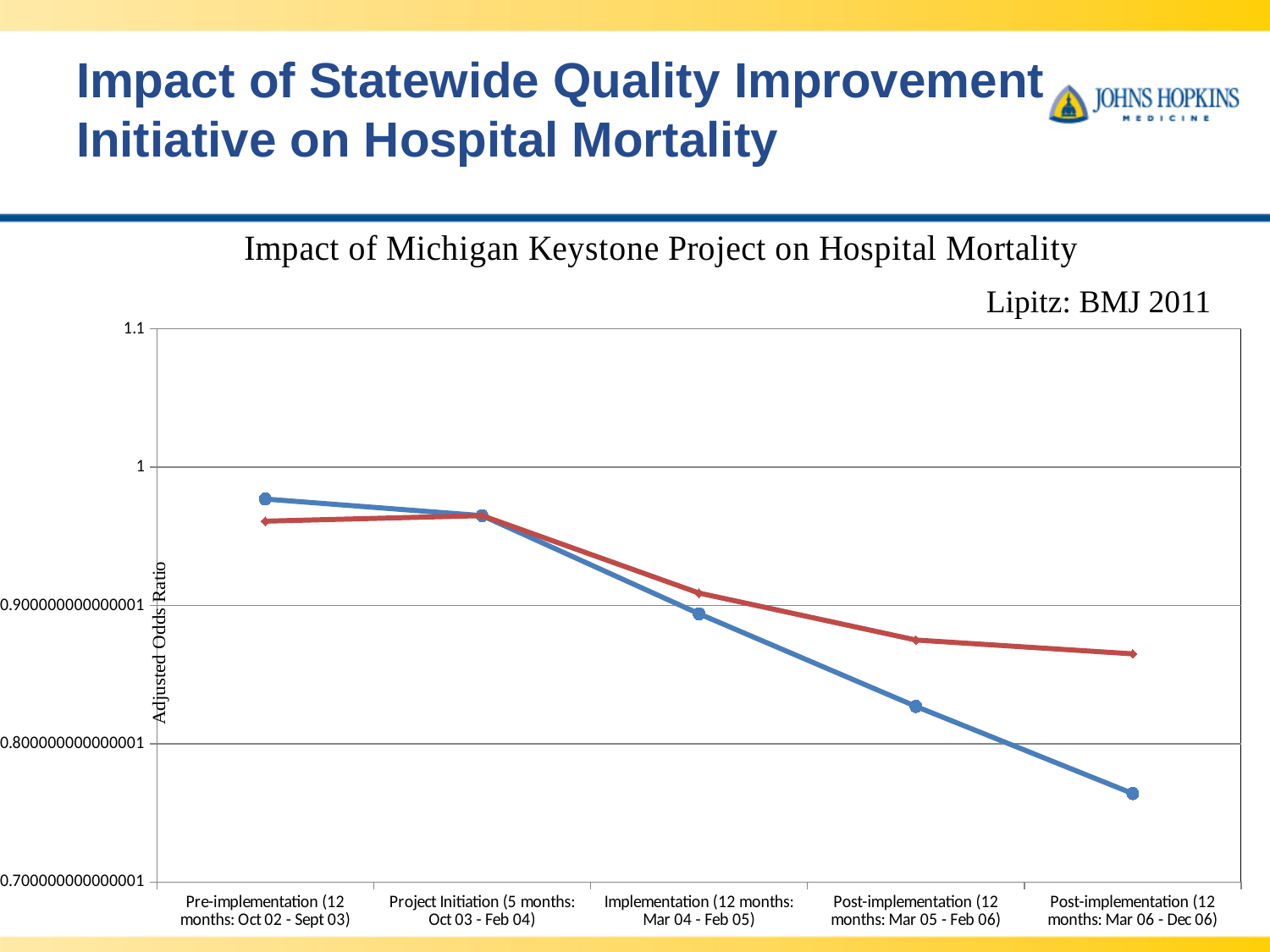
Is the value of the red line for Post-implementation (12 months: Mar 05 - Feb 06) greater or less than 0.9? less What is the title of the chart? Impact of Michigan Keystone Project on Hospital Mortality How many lines are plotted on the chart? 2 What kind of chart is shown on the slide? line chart How many time-period categories are shown on the x axis? 5 Do the values of the red line rise or fall from left to right along the x axis? fall Is the value of the blue line for Post-implementation (12 months: Mar 06 - Dec 06) greater or less than 0.8? less Do the values of the blue line rise or fall from left to right along the x axis? fall What is the label on the vertical axis of the chart? Adjusted Odds Ratio At Post-implementation (12 months: Mar 06 - Dec 06), which line has the higher value, the blue line or the red line? the red line At which category does the blue line reach its lowest value? Post-implementation (12 months: Mar 06 - Dec 06) Is the value of the red line for Post-implementation (12 months: Mar 06 - Dec 06) greater or less than 0.8? greater